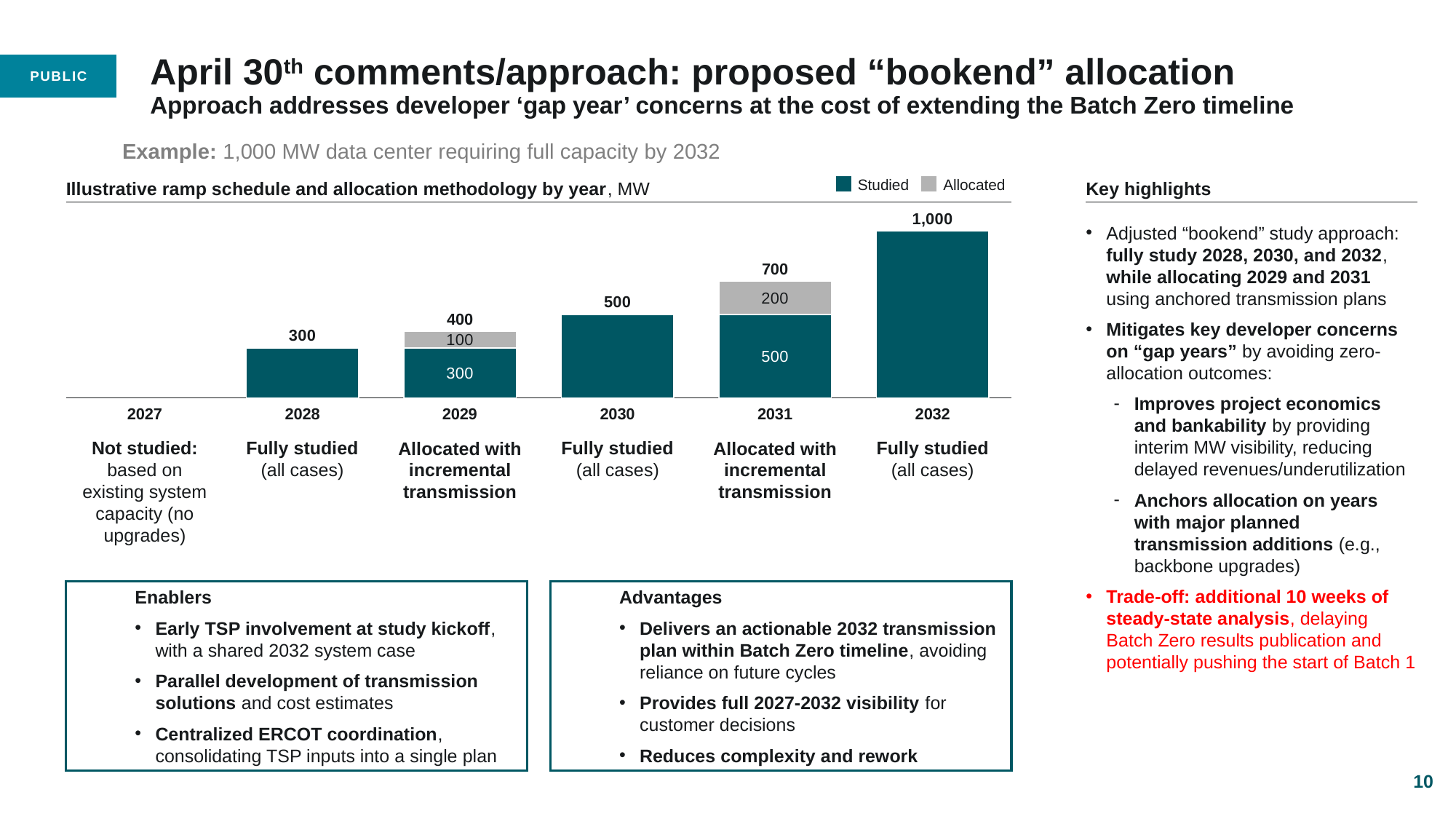
What is the total value shown for 2031? 700 Which series is shown in grey in the legend? Allocated What is the Allocated value for 2029? 100 Which is larger, the total for 2029 or the total for 2030? 2030 What unit is the chart measured in, according to its title? MW What is the difference between the total for 2032 and the total for 2031? 300 Which year has the highest total value? 2032 Do the total values rise or fall from 2028 to 2032? Rise How many series does the legend list? 2 What kind of chart is shown? Stacked bar chart What is the Studied value for 2031? 500 What is the total value shown for 2032? 1,000